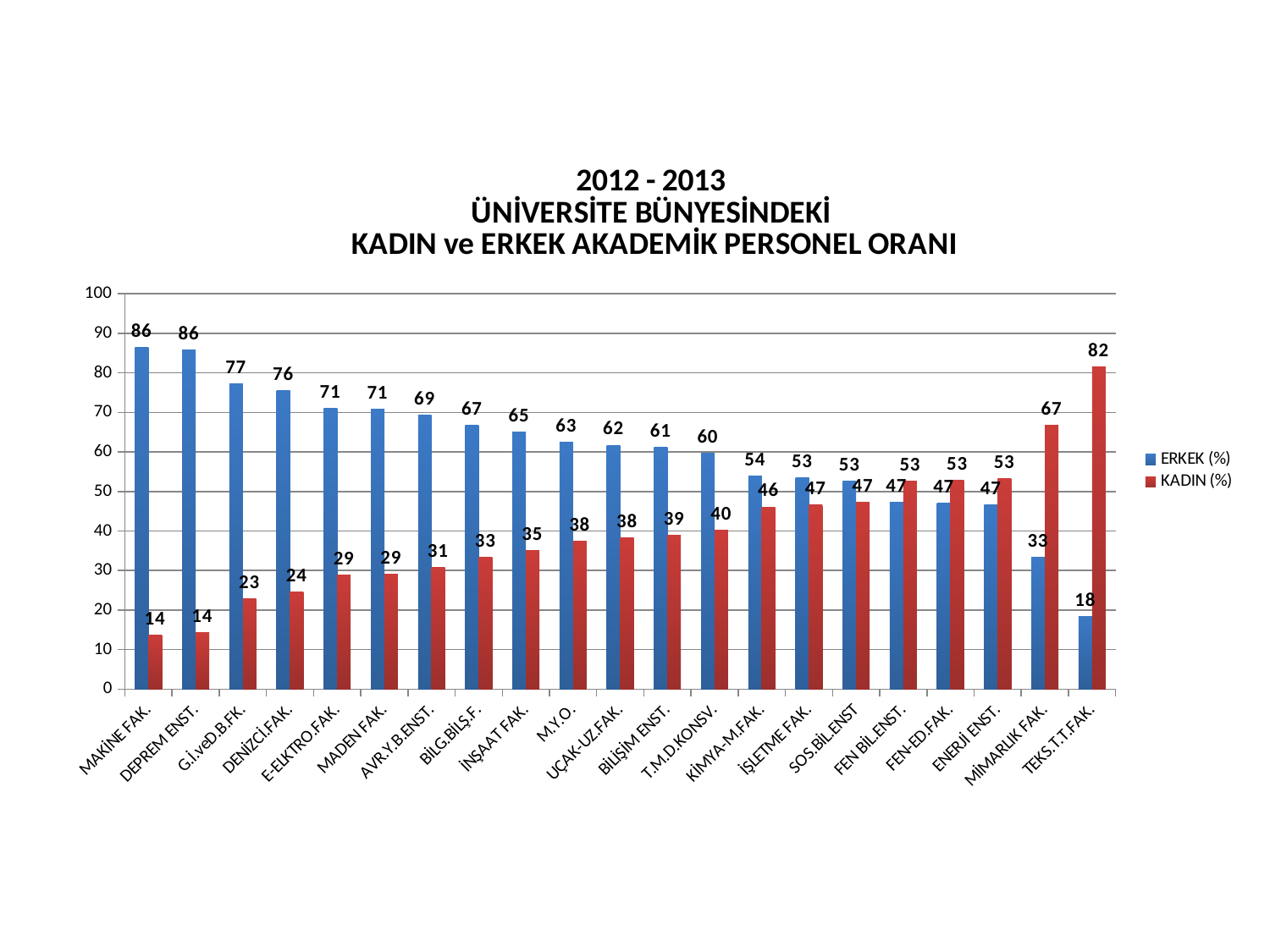
Which colour represents the KADIN (%) series? Red What is the KADIN (%) value for MİMARLIK FAK.? 67 How many series does the legend list? 2 Do the ERKEK (%) values generally rise or fall from left to right along the x axis? Fall What is the KADIN (%) value for T.M.D.KONSV.? 40 What is the ERKEK (%) value for MADEN FAK.? 71 Which category has the highest KADIN (%) value? TEKS.T.T.FAK. What is the difference between the ERKEK (%) and KADIN (%) values for MAKİNE FAK.? 72 Which is larger for FEN-ED.FAK., the ERKEK (%) value or the KADIN (%) value? KADIN (%) What kind of chart is shown on the slide? Bar chart Which category has the lowest ERKEK (%) value? TEKS.T.T.FAK. How many categories are shown on the x axis? 21